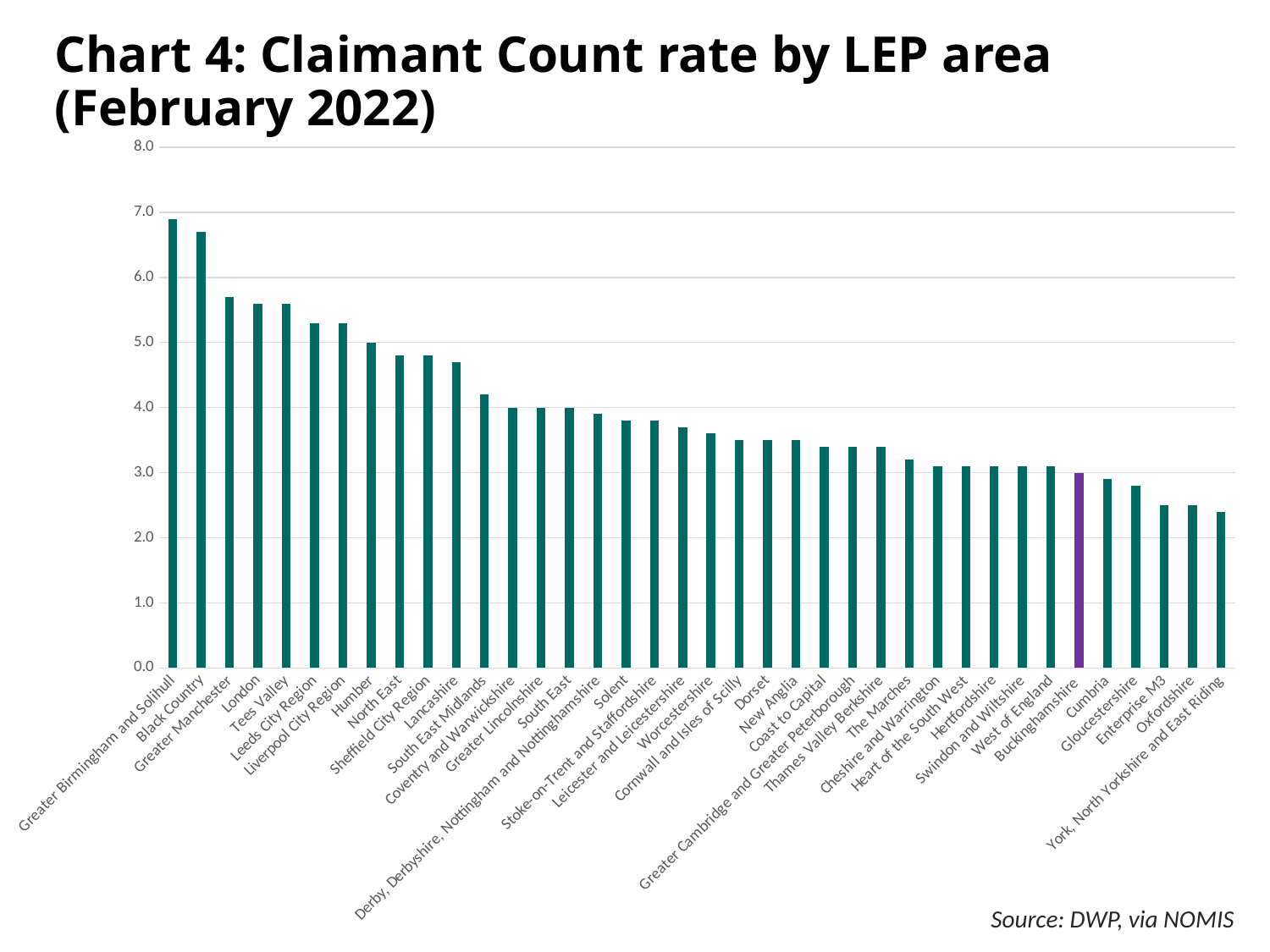
Is the Claimant Count rate for London greater or less than 5.0? greater Which LEP area's bar is shown in a different colour (purple) from the others? Buckinghamshire Is the Claimant Count rate for Black Country greater or less than 6.0? greater Do the Claimant Count rates rise or fall moving from left to right across the chart? fall Is the Claimant Count rate for Lancashire greater or less than 5.0? less Which has the higher Claimant Count rate, Greater Manchester or Dorset? Greater Manchester What kind of chart is shown on the slide? Bar chart What is the source given for the chart? DWP, via NOMIS Which LEP area has the highest Claimant Count rate? Greater Birmingham and Solihull Which has the higher Claimant Count rate, London or Humber? London How many LEP areas are plotted in the chart? 38